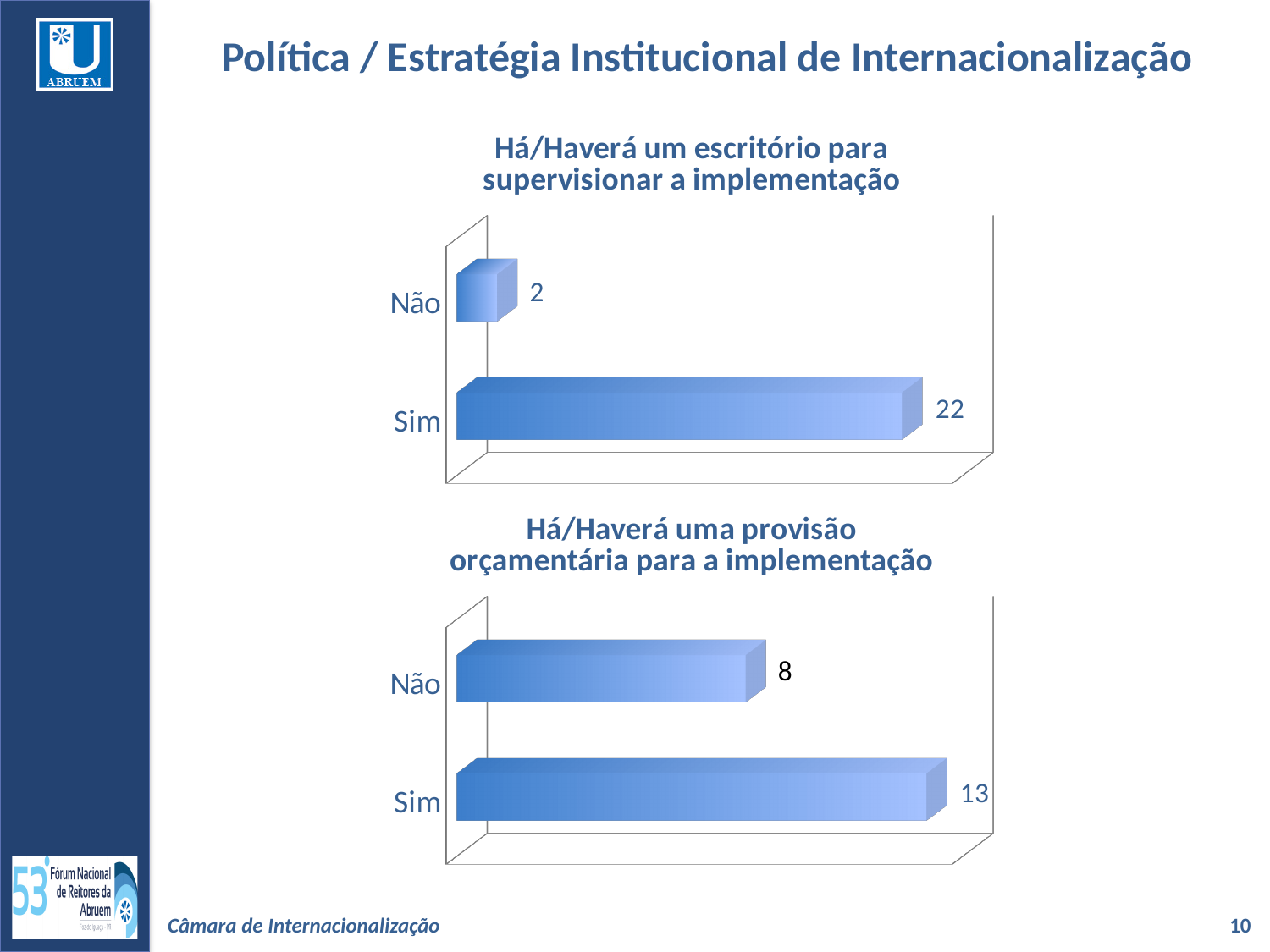
In the bottom chart, which category has the lowest value? Não In the bottom chart 'Há/Haverá uma provisão orçamentária para a implementação', what is the value for Não? 8 What kind of chart is the bottom chart? Bar chart What is the title of the top chart? Há/Haverá um escritório para supervisionar a implementação How many categories does the top chart show? 2 In the bottom chart 'Há/Haverá uma provisão orçamentária para a implementação', what is the value for Sim? 13 In the top chart, what is the difference between the values for Sim and Não? 20 In the top chart, which category has the highest value? Sim In the top chart 'Há/Haverá um escritório para supervisionar a implementação', what is the value for Sim? 22 In the bottom chart, which is larger, the value for Sim or the value for Não? Sim In the bottom chart, what is the difference between the values for Sim and Não? 5 In the top chart 'Há/Haverá um escritório para supervisionar a implementação', what is the value for Não? 2